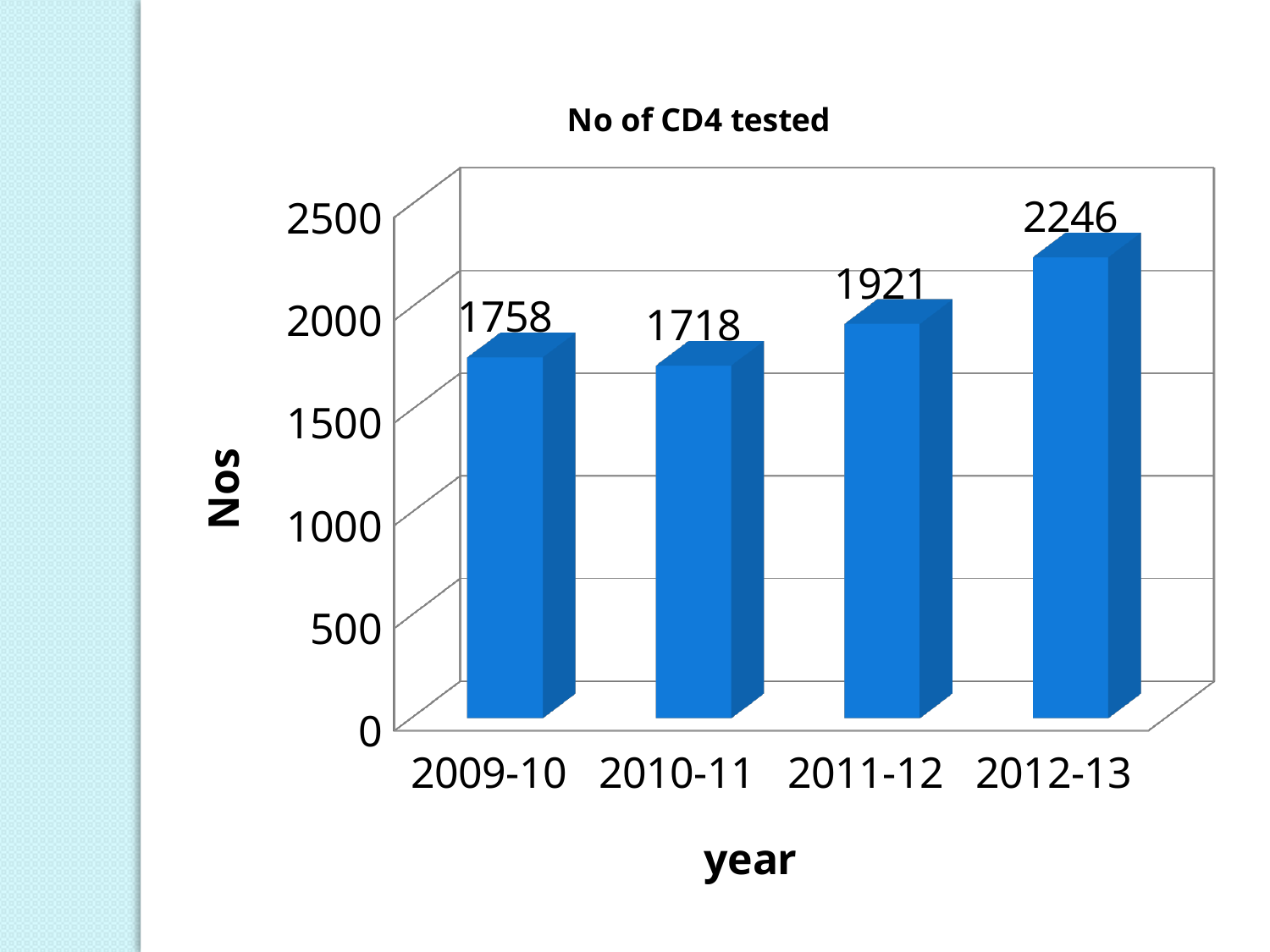
What kind of chart is shown on the slide? Bar chart Which year has the highest number of CD4 tested? 2012-13 What is the difference in the number of CD4 tested between 2009-10 and 2010-11? 40 What is the number of CD4 tested in 2009-10? 1758 What is the number of CD4 tested in 2010-11? 1718 How many years are shown on the chart? 4 What is the difference in the number of CD4 tested between 2012-13 and 2011-12? 325 Which year has the lowest number of CD4 tested? 2010-11 Which year has a larger number of CD4 tested, 2011-12 or 2009-10? 2011-12 What is the title of the chart? No of CD4 tested What is the number of CD4 tested in 2012-13? 2246 What is the number of CD4 tested in 2011-12? 1921